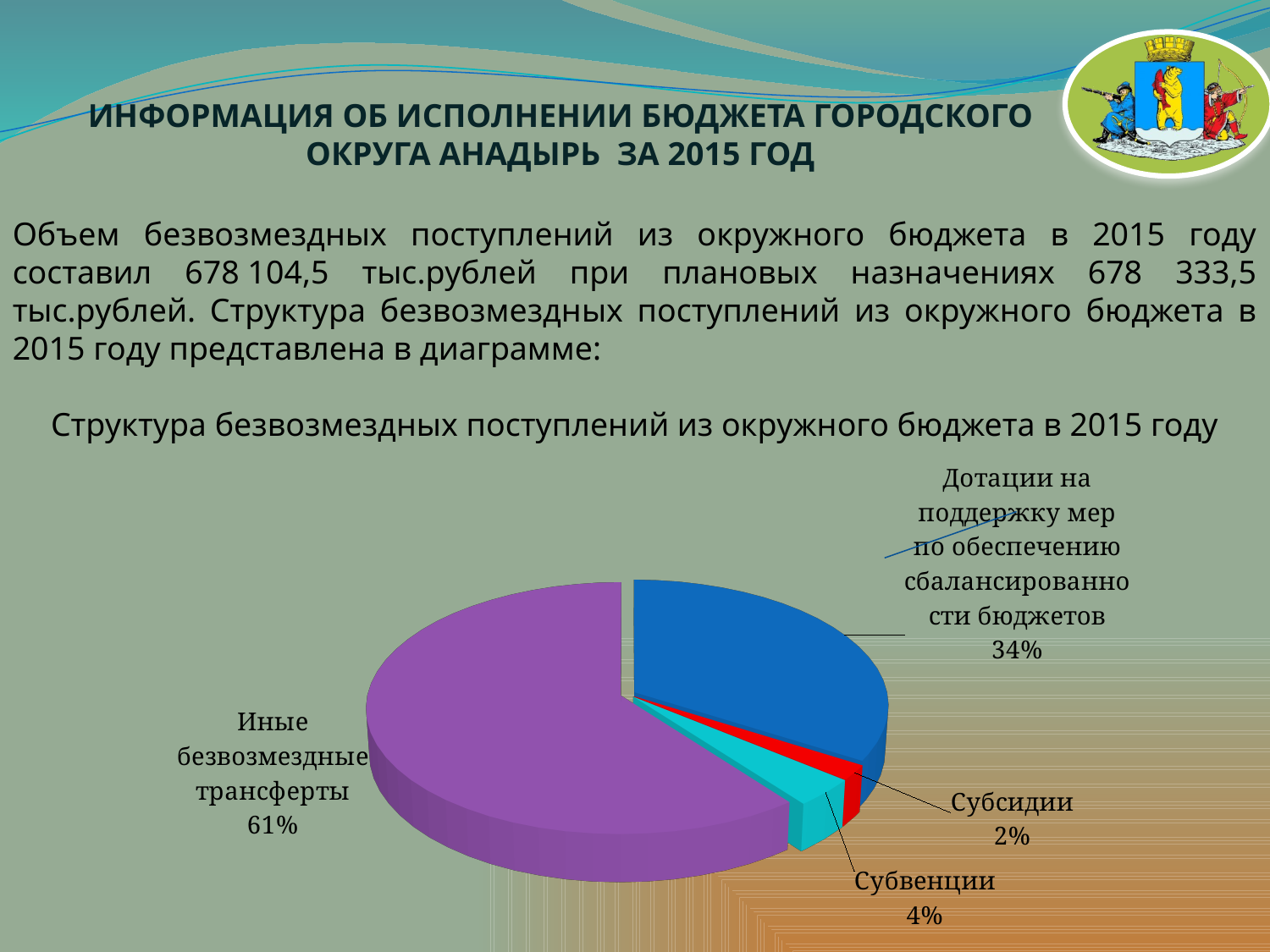
How many slices does the pie chart have? 4 What is the difference in percentage points between Иные безвозмездные трансферты and Дотации на поддержку мер по обеспечению сбалансированности бюджетов? 27 percentage points Which is larger: Субвенции or Субсидии? Субвенции What is the title of the chart? Структура безвозмездных поступлений из окружного бюджета в 2015 году What share of the pie is Субсидии? 2% What share of the pie is Иные безвозмездные трансферты? 61% What colour is the Иные безвозмездные трансферты slice? Purple What share of the pie is Субвенции? 4% Which slice of the pie is the smallest? Субсидии What kind of chart is shown on the slide? Pie chart Which slice of the pie is the largest? Иные безвозмездные трансферты